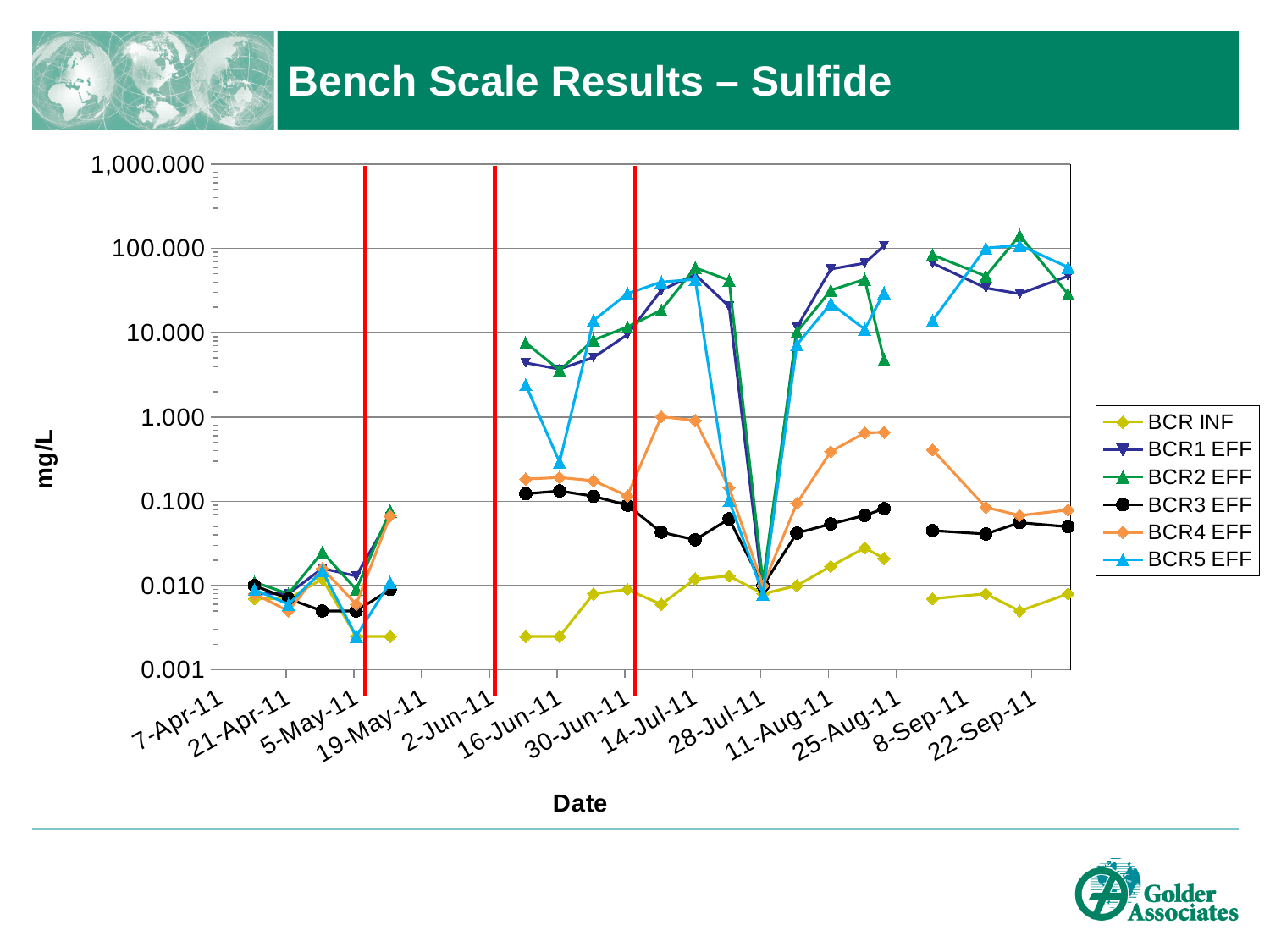
On 14-Jul-11, which is larger: BCR4 EFF or BCR3 EFF? BCR4 EFF Is the value for BCR2 EFF on 16-Jun-11 greater or less than 1.000? greater What is the label on the y axis of the chart? mg/L Is the value for BCR4 EFF on 14-Jul-11 greater or less than 0.100? greater What is the title of the chart on the slide? Bench Scale Results – Sulfide Which series has the lowest value on 14-Jul-11? BCR INF Is the value for BCR1 EFF on 25-Aug-11 greater or less than 10.000? greater What kind of chart is shown on the slide? line chart How many series does the legend list? 6 On 16-Jun-11, which is larger: BCR2 EFF or BCR INF? BCR2 EFF